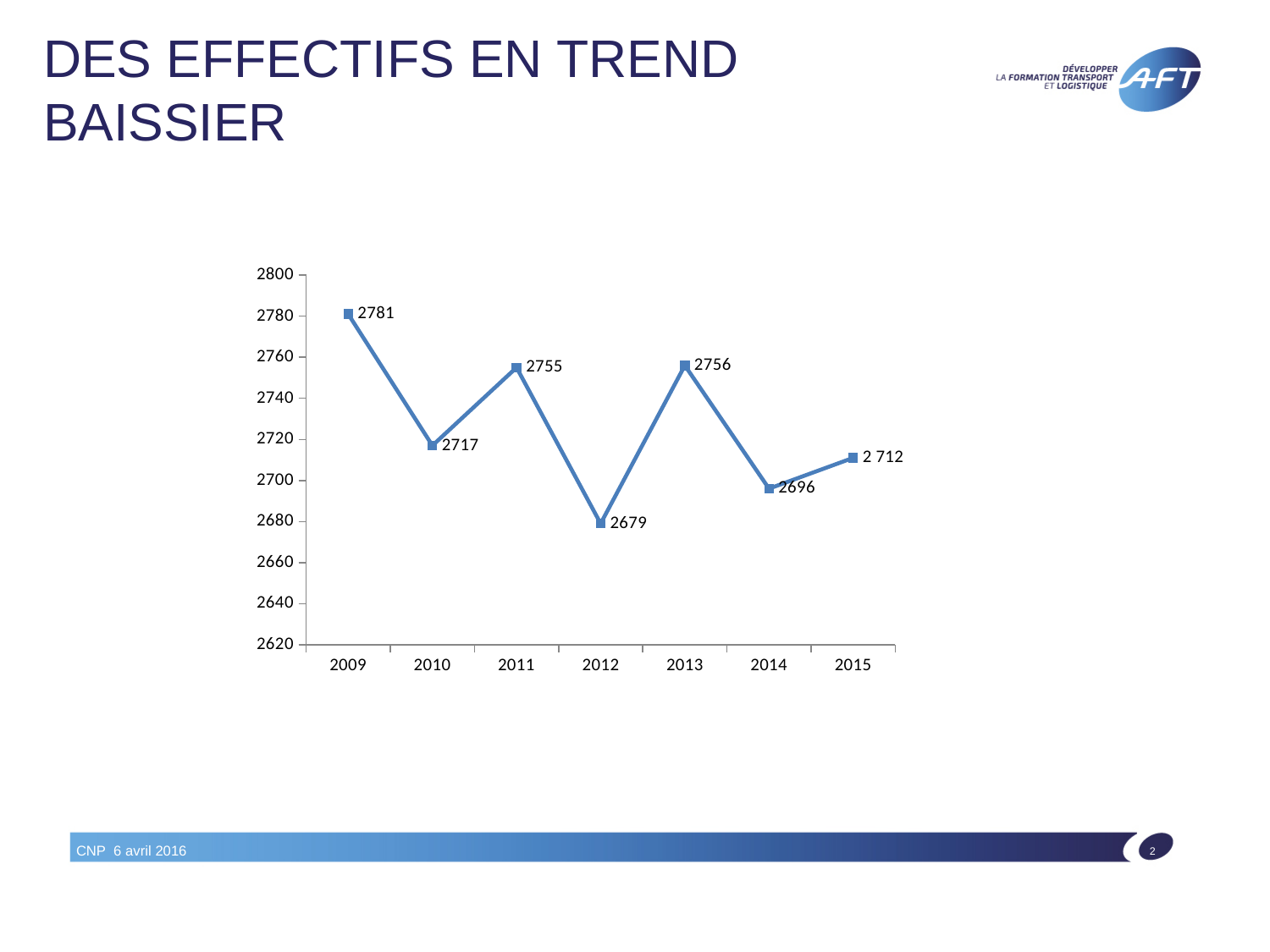
What is the value for 2015? 2 712 Overall, does the value rise or fall from 2009 to 2015? fall What is the difference between the values for 2013 and 2014? 60 Which year has the lowest value? 2012 What is the difference between the values for 2009 and 2010? 64 What is the value for 2009? 2781 How many years are plotted on the chart? 7 What kind of chart is shown on the slide? line chart Which year has the highest value? 2009 Which is larger, the value for 2010 or the value for 2014? 2010 Is the value for 2012 greater or less than 2700? less What is the value for 2012? 2679